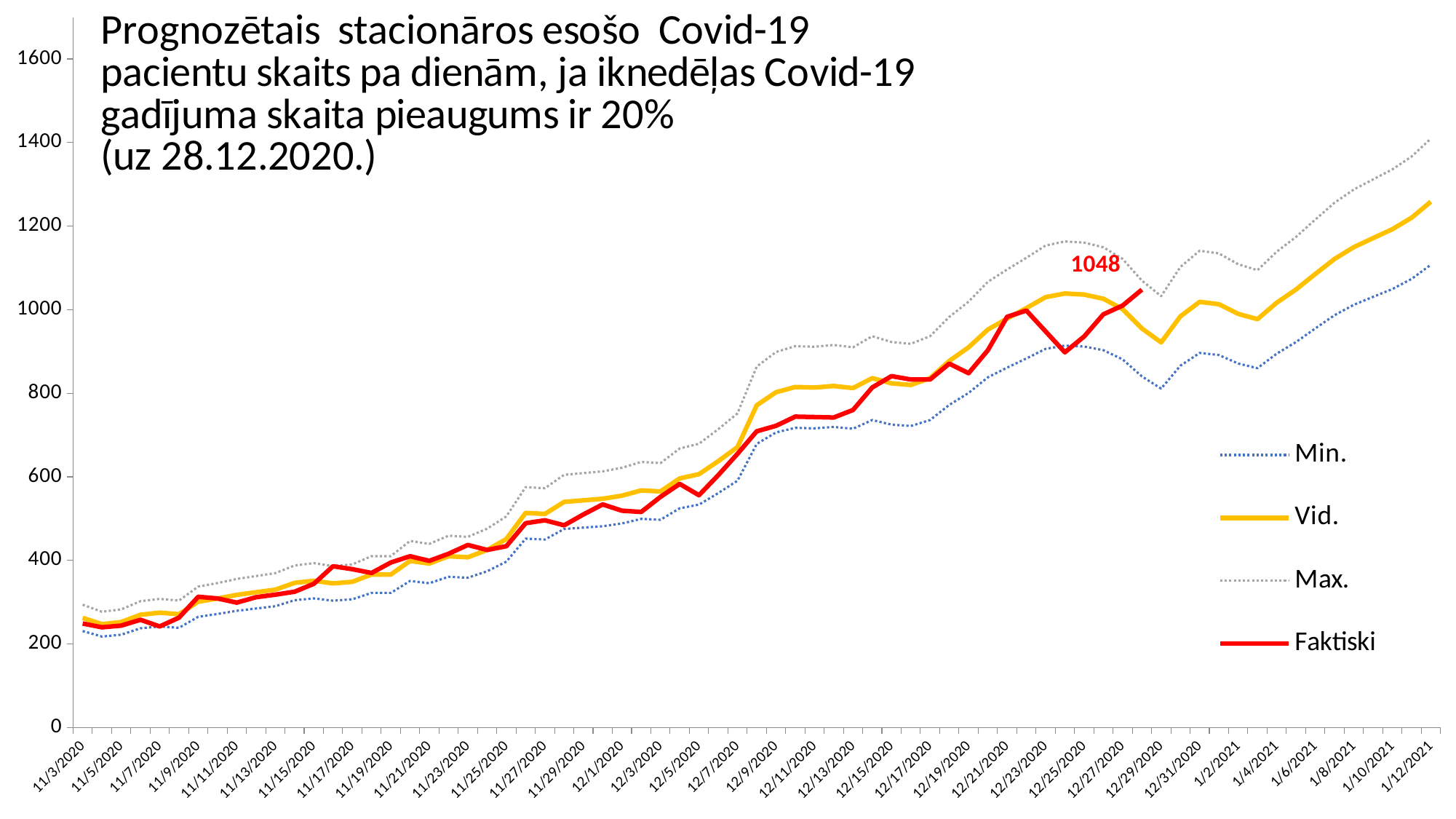
What kind of chart is shown on the slide? line chart Is the value of the Min. line at 1/12/2021 greater or less than 1200? less Is the value of the Max. line at 1/12/2021 greater or less than 1200? greater Is the value of the Faktiski line at 11/3/2020 greater or less than 400? less Do the values of the Vid. line generally rise or fall from 11/3/2020 to 1/12/2021? rise What is the value printed as a data label on the Faktiski line? 1048 Which series has the highest value at 1/12/2021? Max. What colour is the Faktiski line? red How many series does the legend list? 4 At 1/12/2021, which is larger: the Max. line or the Min. line? Max. What are the entries listed in the legend? Min., Vid., Max., Faktiski